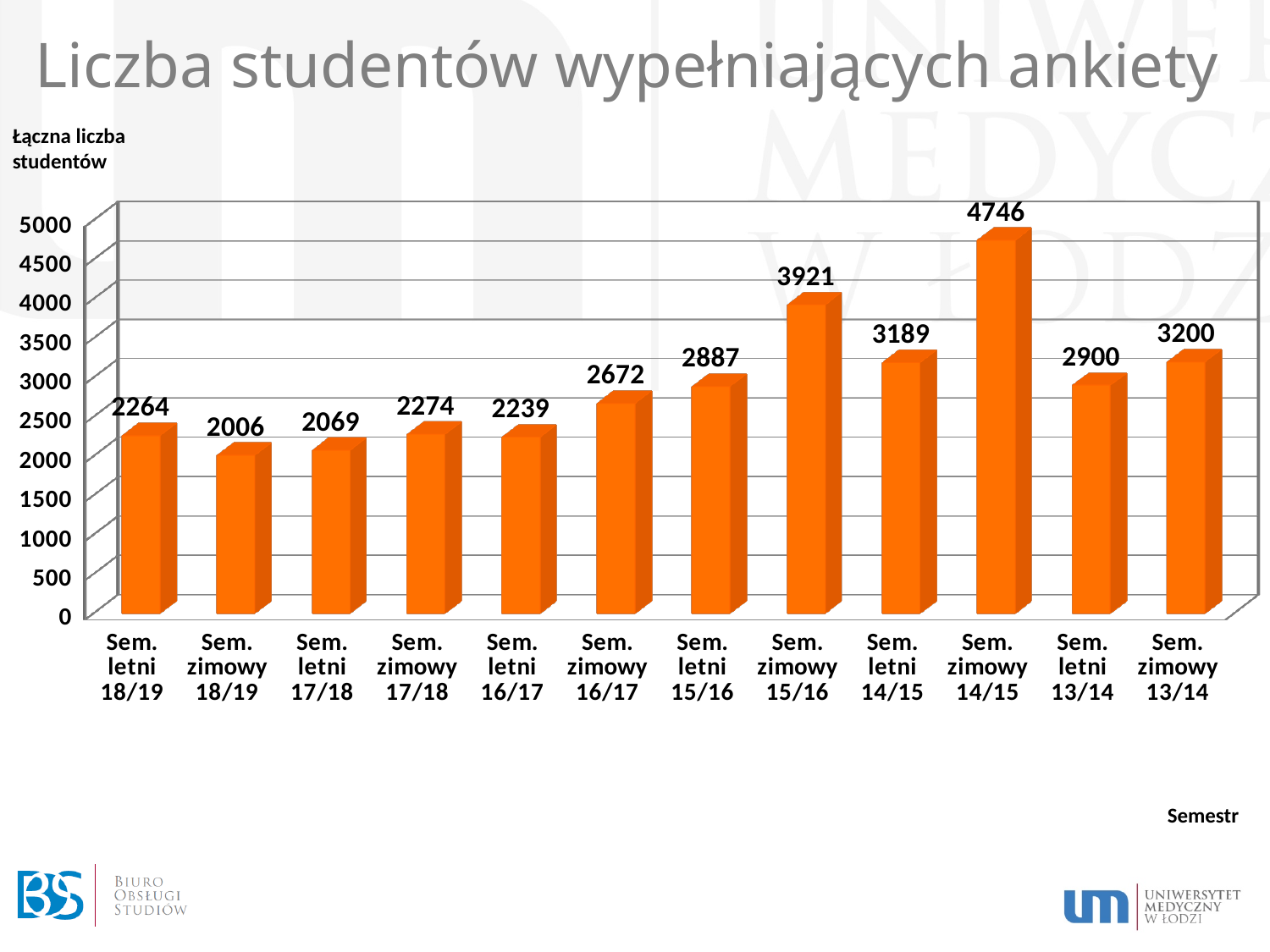
What is the number of students for Sem. zimowy 15/16? 3921 What is the title of the chart? Liczba studentów wypełniających ankiety Which semester has the lowest number of students filling in surveys? Sem. zimowy 18/19 Which semester has the highest number of students filling in surveys? Sem. zimowy 14/15 What is the difference between the values for Sem. zimowy 14/15 and Sem. zimowy 15/16? 825 What is the number of students for Sem. letni 16/17? 2239 Is the value for Sem. letni 14/15 greater or less than 3000? greater Which is larger, the value for Sem. letni 15/16 or the value for Sem. zimowy 16/17? Sem. letni 15/16 How many semesters (bars) are shown in the chart? 12 What type of chart is shown on the slide? Bar chart What is the difference between the values for Sem. zimowy 13/14 and Sem. letni 13/14? 300 What is the number of students for Sem. zimowy 13/14? 3200